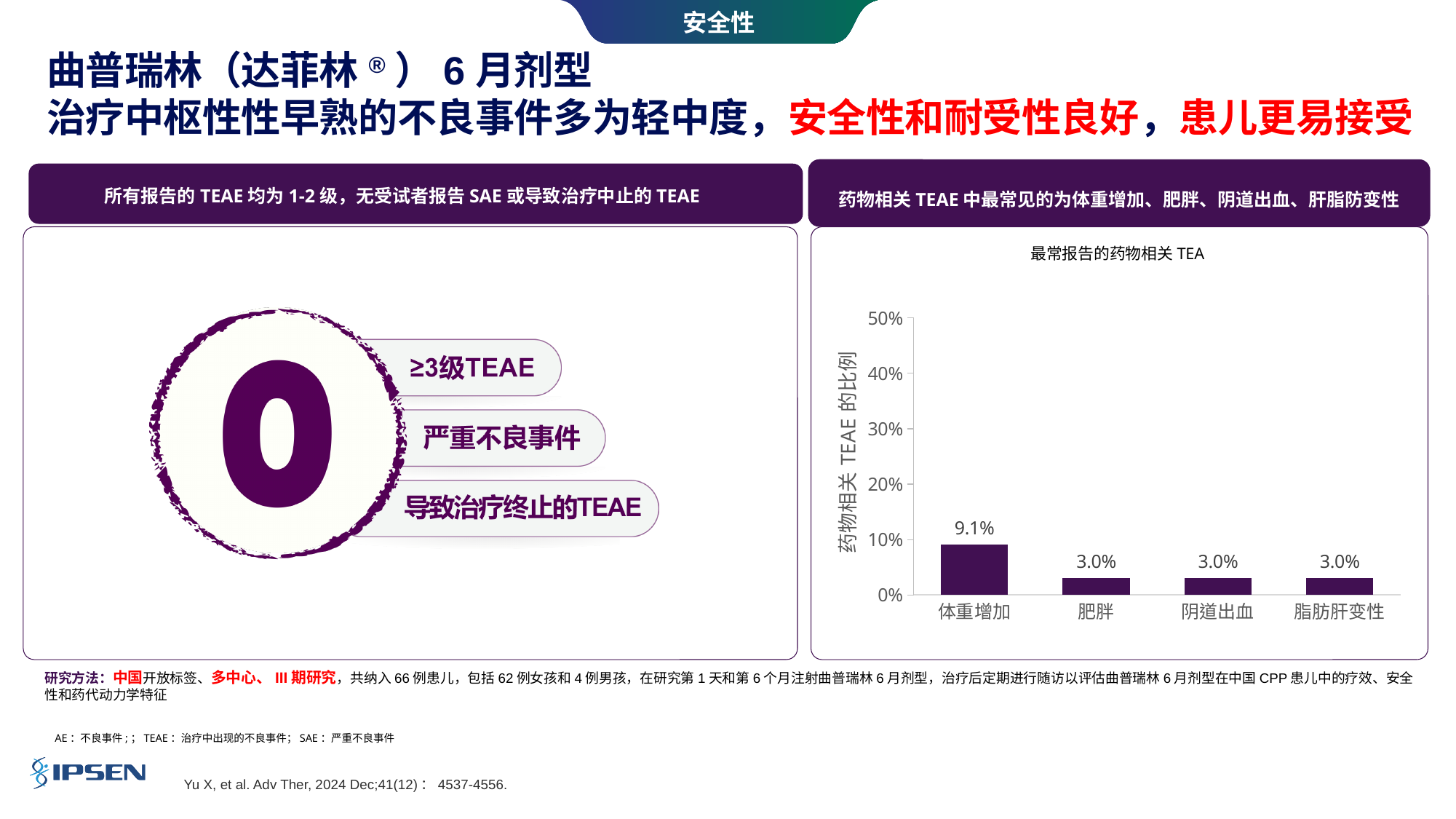
How many categories are shown on the x axis of the chart? 4 Which is larger, the value for 体重增加 or the value for 阴道出血? 体重增加 What is the value for 阴道出血 in the chart? 3.0% What is the value for 肥胖 in the chart? 3.0% What is the value for 体重增加 in the chart? 9.1% What is the title of the chart? 最常报告的药物相关 TEA Which category has the highest value in the chart? 体重增加 What is the difference between the values for 体重增加 and 肥胖? 6.1% What is the label of the y axis of the chart? 药物相关 TEAE 的比例 What kind of chart is shown on the slide? bar chart Is the value for 体重增加 greater or less than 10%? less What is the value for 脂肪肝变性 in the chart? 3.0%